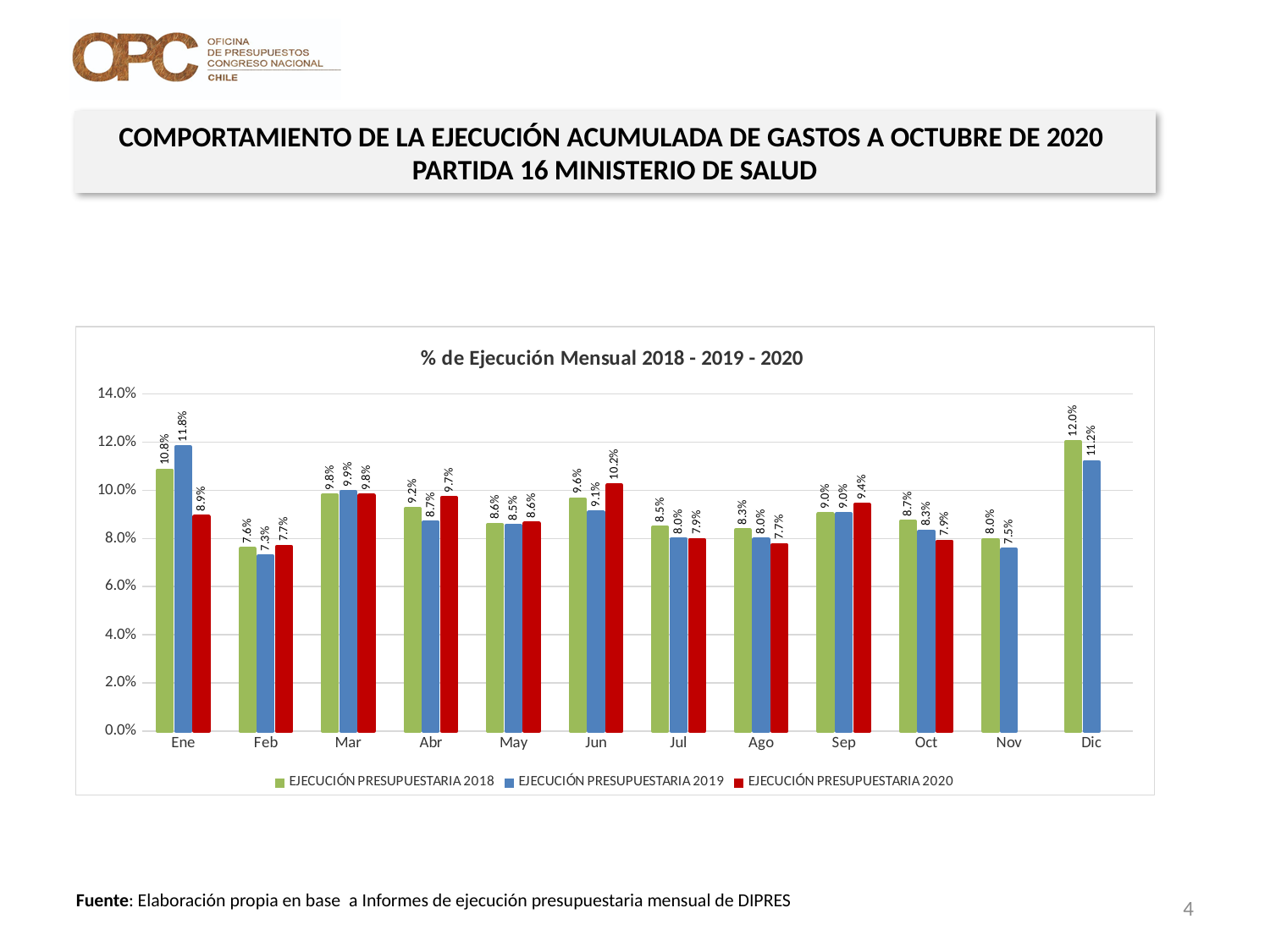
How many series does the legend list? 3 Which month has the highest value for EJECUCIÓN PRESUPUESTARIA 2018? Dic How many months are shown on the x axis? 12 What is the difference between the 2019 and 2020 values in Ene? 2.9 percentage points Which month has the highest value for EJECUCIÓN PRESUPUESTARIA 2020? Jun What is the value for EJECUCIÓN PRESUPUESTARIA 2020 in Jun? 10.2% What is the value for EJECUCIÓN PRESUPUESTARIA 2018 in Nov? 8.0% What is the value for EJECUCIÓN PRESUPUESTARIA 2019 in Ene? 11.8% What kind of chart is shown on the slide? Bar chart In Abr, which series has the larger value: EJECUCIÓN PRESUPUESTARIA 2018 or EJECUCIÓN PRESUPUESTARIA 2020? EJECUCIÓN PRESUPUESTARIA 2020 Which month has the lowest value for EJECUCIÓN PRESUPUESTARIA 2019? Feb What is the title of the chart? % de Ejecución Mensual 2018 - 2019 - 2020